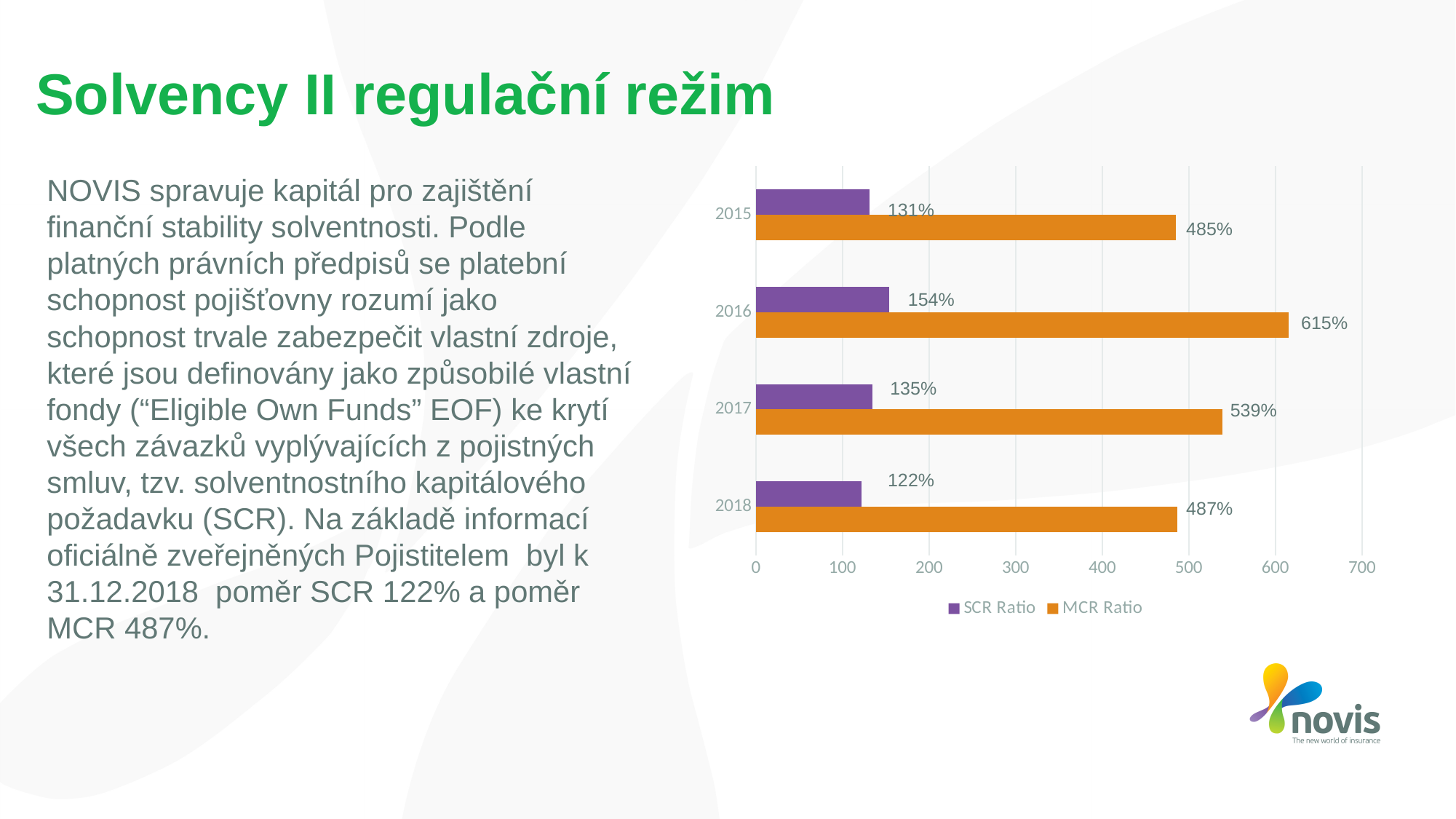
Which colour represents the MCR Ratio series? Orange What is the difference between the MCR Ratio in 2016 and in 2017? 76% What kind of chart is shown on the slide? Bar chart What is the SCR Ratio for 2018? 122% What is the difference between the MCR Ratio and the SCR Ratio in 2018? 365% How many series does the legend list? 2 Which is larger, the SCR Ratio for 2016 or the SCR Ratio for 2017? 2016 What is the MCR Ratio for 2016? 615% How many years are shown on the chart? 4 What is the MCR Ratio for 2015? 485% Which year has the lowest SCR Ratio? 2018 Which year has the highest MCR Ratio? 2016